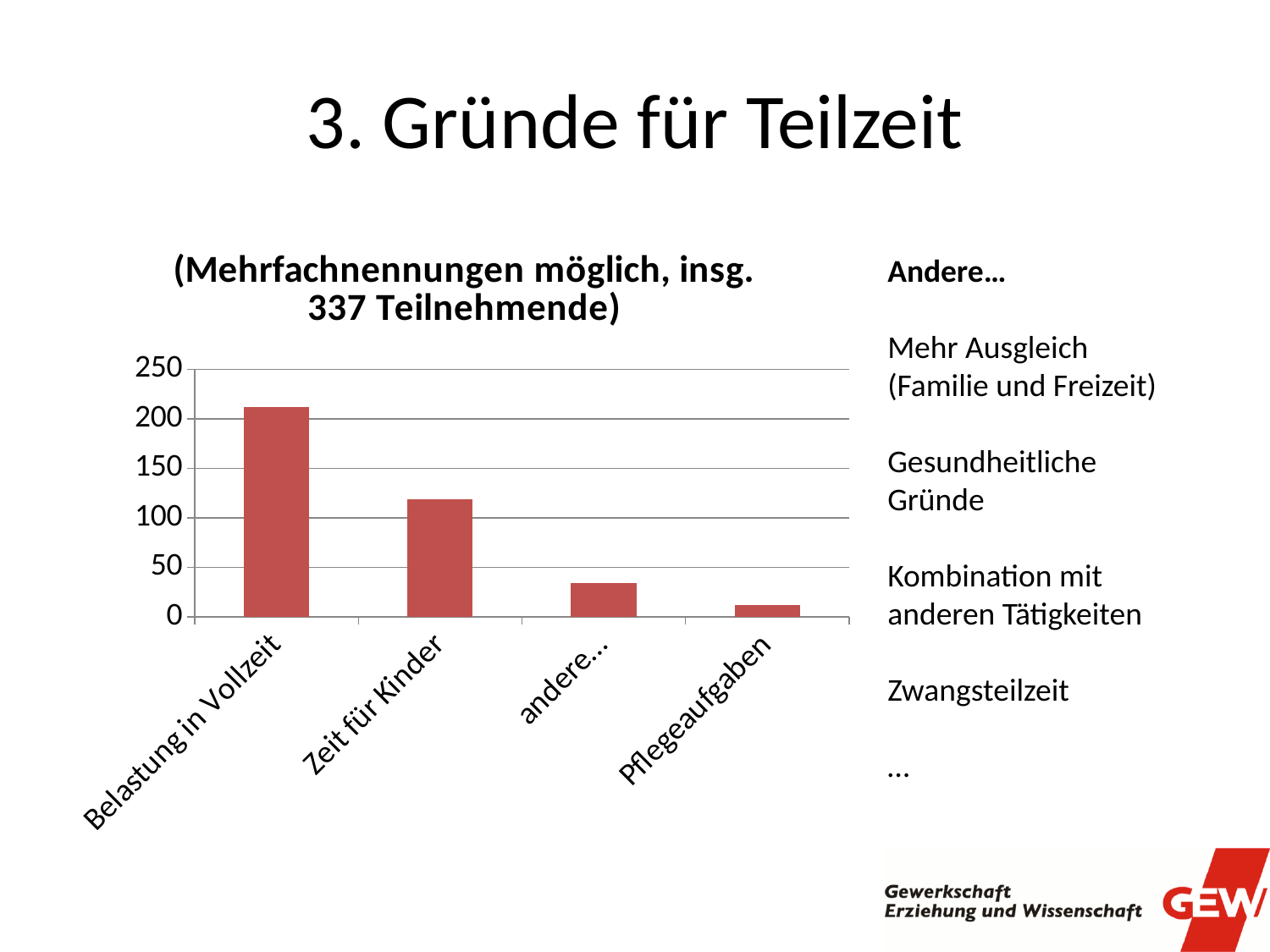
Do the bar values rise or fall from left to right along the x axis? fall Which category has the highest value in the chart? Belastung in Vollzeit Which is larger, the value for Zeit für Kinder or the value for Pflegeaufgaben? Zeit für Kinder Is the value for andere... greater or less than 50? less Is the value for Zeit für Kinder greater or less than 150? less Is the value for Pflegeaufgaben greater or less than 50? less What kind of chart is shown on the slide? bar chart Which category has the lowest value in the chart? Pflegeaufgaben What is the title of the chart? (Mehrfachnennungen möglich, insg. 337 Teilnehmende) How many categories are shown on the x axis of the chart? 4